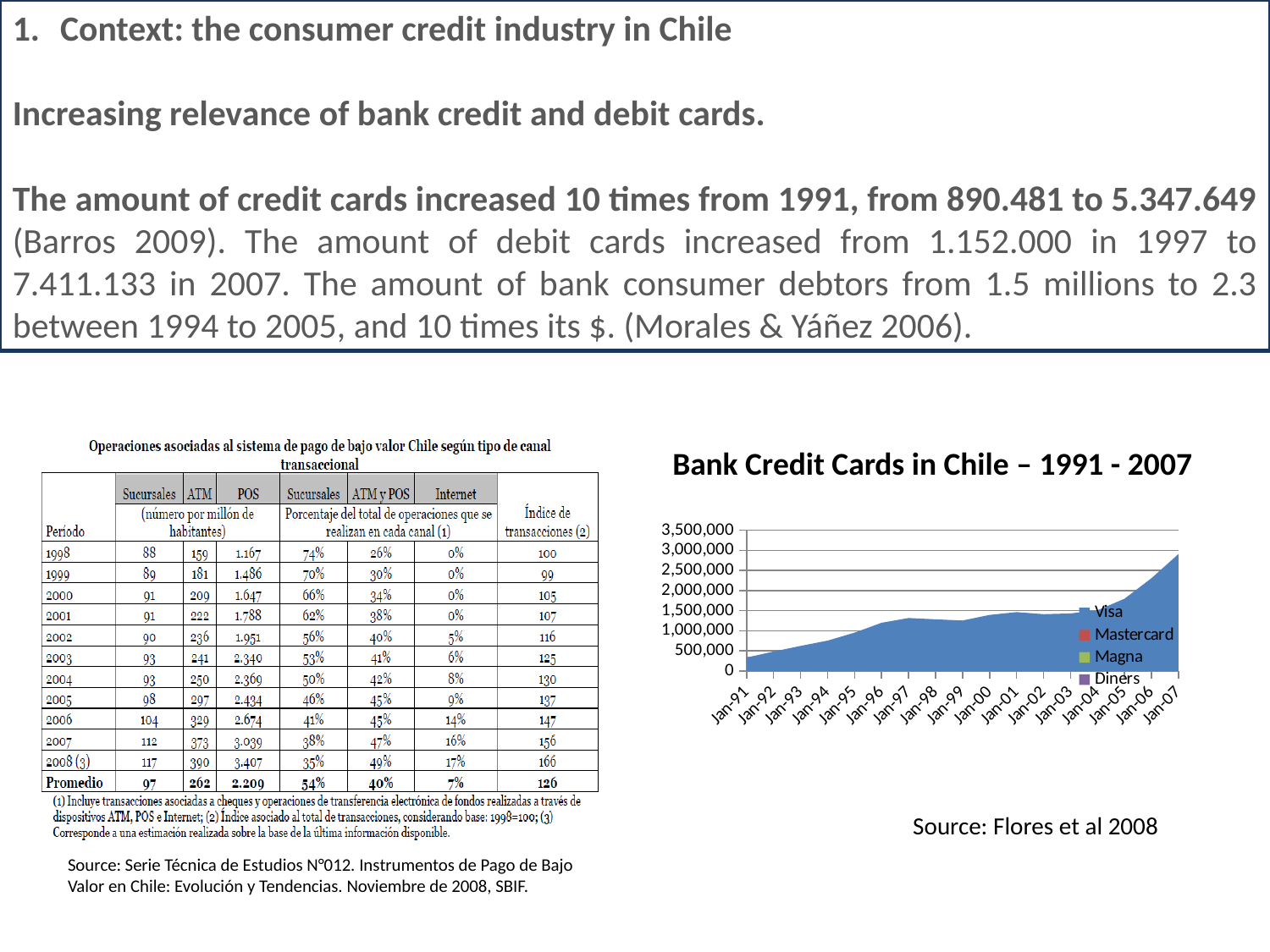
In the "Bank Credit Cards in Chile" chart, which year has the lowest total value? Jan-91 In the "Bank Credit Cards in Chile" chart, is the total value for Jan-97 greater or less than 1,000,000? greater In the "Bank Credit Cards in Chile" chart, do the values generally rise or fall from Jan-91 to Jan-07? Rise How many series does the legend of the "Bank Credit Cards in Chile" chart list? 4 How many points are shown along the x axis of the "Bank Credit Cards in Chile" chart? 17 In the "Bank Credit Cards in Chile" chart, is the total value for Jan-94 greater or less than 1,000,000? less In the "Bank Credit Cards in Chile" chart, is the total value for Jan-06 greater or less than 2,000,000? greater In the "Bank Credit Cards in Chile" chart, which is larger, the total value for Jan-07 or for Jan-01? Jan-07 What kind of chart is "Bank Credit Cards in Chile – 1991 - 2007"? Area chart In the "Bank Credit Cards in Chile" chart, which year has the highest total value? Jan-07 Which series is listed first in the legend of the "Bank Credit Cards in Chile" chart? Visa